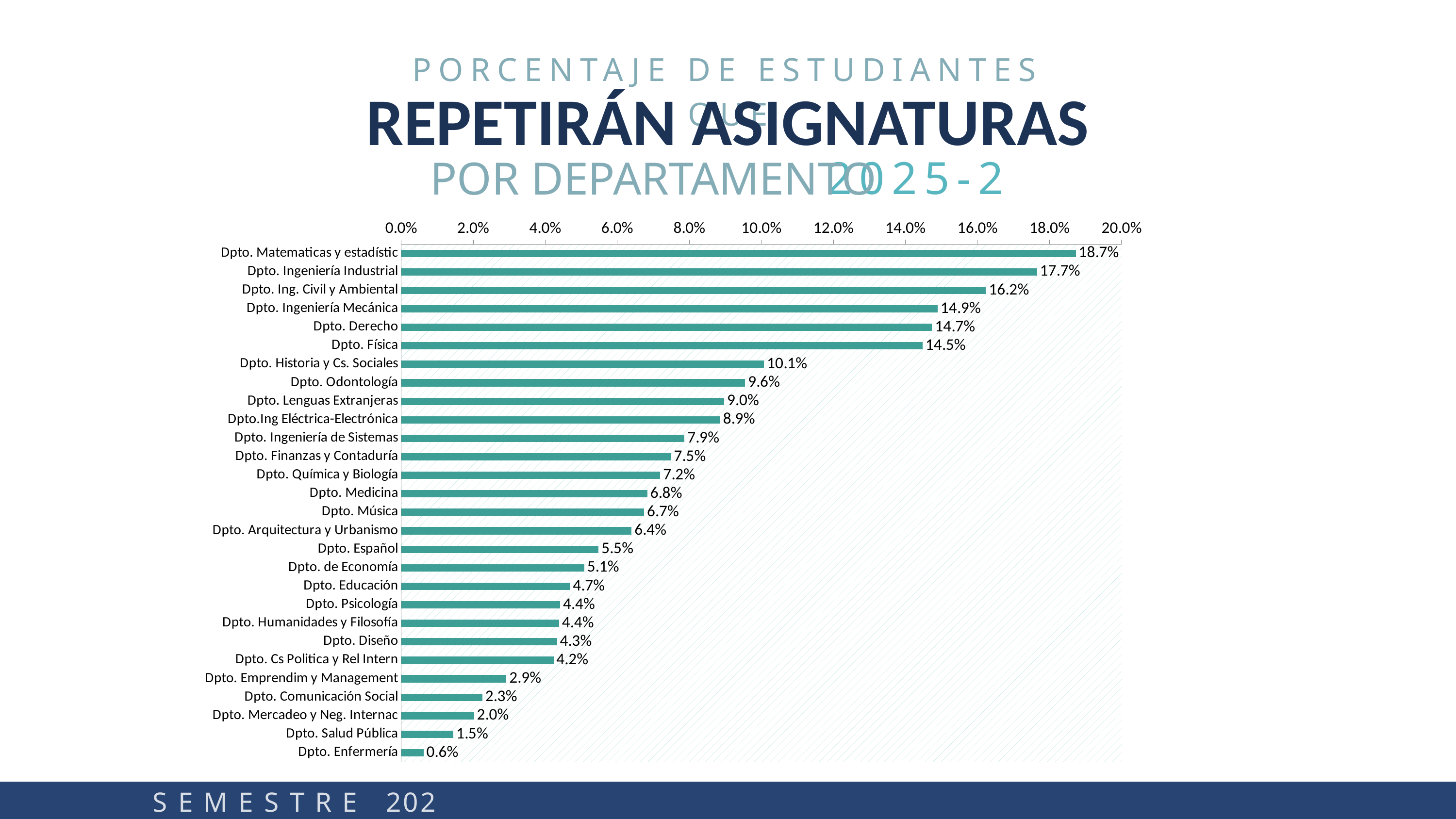
Which department has the highest percentage? Dpto. Matematicas y estadístic Which is larger, the value for Dpto. Medicina or the value for Dpto. Español? Dpto. Medicina What is the value for Dpto. Derecho? 14.7% How many departments are shown in the chart? 28 Which department has the lowest percentage? Dpto. Enfermería Do the values rise or fall going from the top bar to the bottom bar? fall What is the maximum value shown on the horizontal axis? 20.0% What kind of chart is shown on the slide? bar chart What is the value for Dpto. Odontología? 9.6% Is the value for Dpto. Física greater or less than 12.0%? greater What is the difference between the values for Dpto. Ingeniería Industrial and Dpto. Ing. Civil y Ambiental? 1.5% What is the value for Dpto. Salud Pública? 1.5%